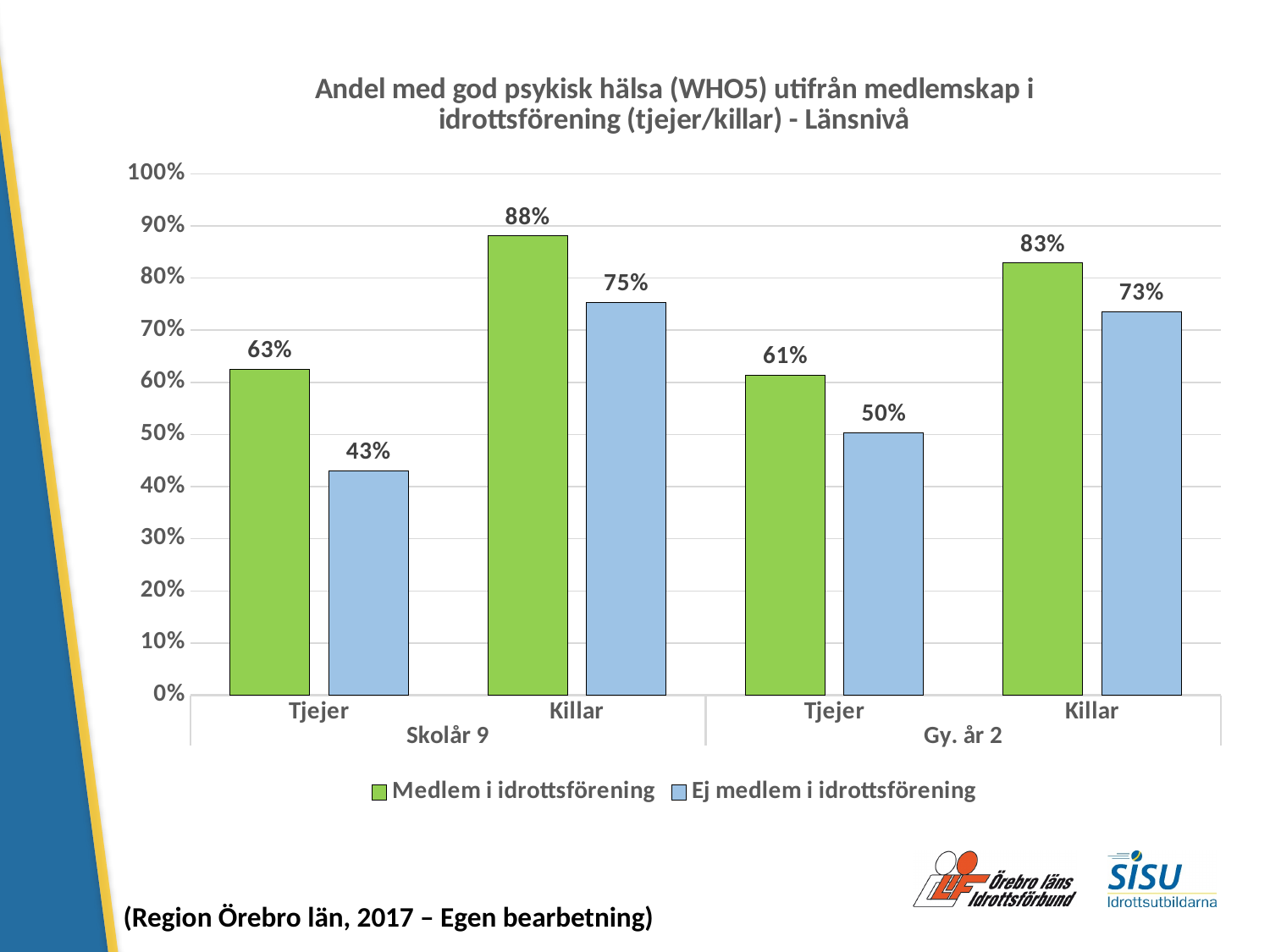
What is the value for 'Ej medlem i idrottsförening' for Tjejer in Skolår 9? 43% How many groups (bar pairs) are shown on the x axis? 4 What kind of chart is shown on the slide? Bar chart How many series does the legend list? 2 What is the value for 'Medlem i idrottsförening' for Tjejer in Skolår 9? 63% Which colour represents 'Medlem i idrottsförening' in the chart? Green Which is larger: 'Ej medlem i idrottsförening' for Killar in Skolår 9 or for Killar in Gy. år 2? Killar in Skolår 9 What is the difference between 'Medlem i idrottsförening' and 'Ej medlem i idrottsförening' for Tjejer in Skolår 9? 20 percentage points Which group has the lowest value for 'Ej medlem i idrottsförening'? Tjejer, Skolår 9 What is the difference between 'Medlem i idrottsförening' and 'Ej medlem i idrottsförening' for Killar in Gy. år 2? 10 percentage points What is the value for 'Ej medlem i idrottsförening' for Killar in Gy. år 2? 73% Which group has the highest value for 'Medlem i idrottsförening'? Killar, Skolår 9